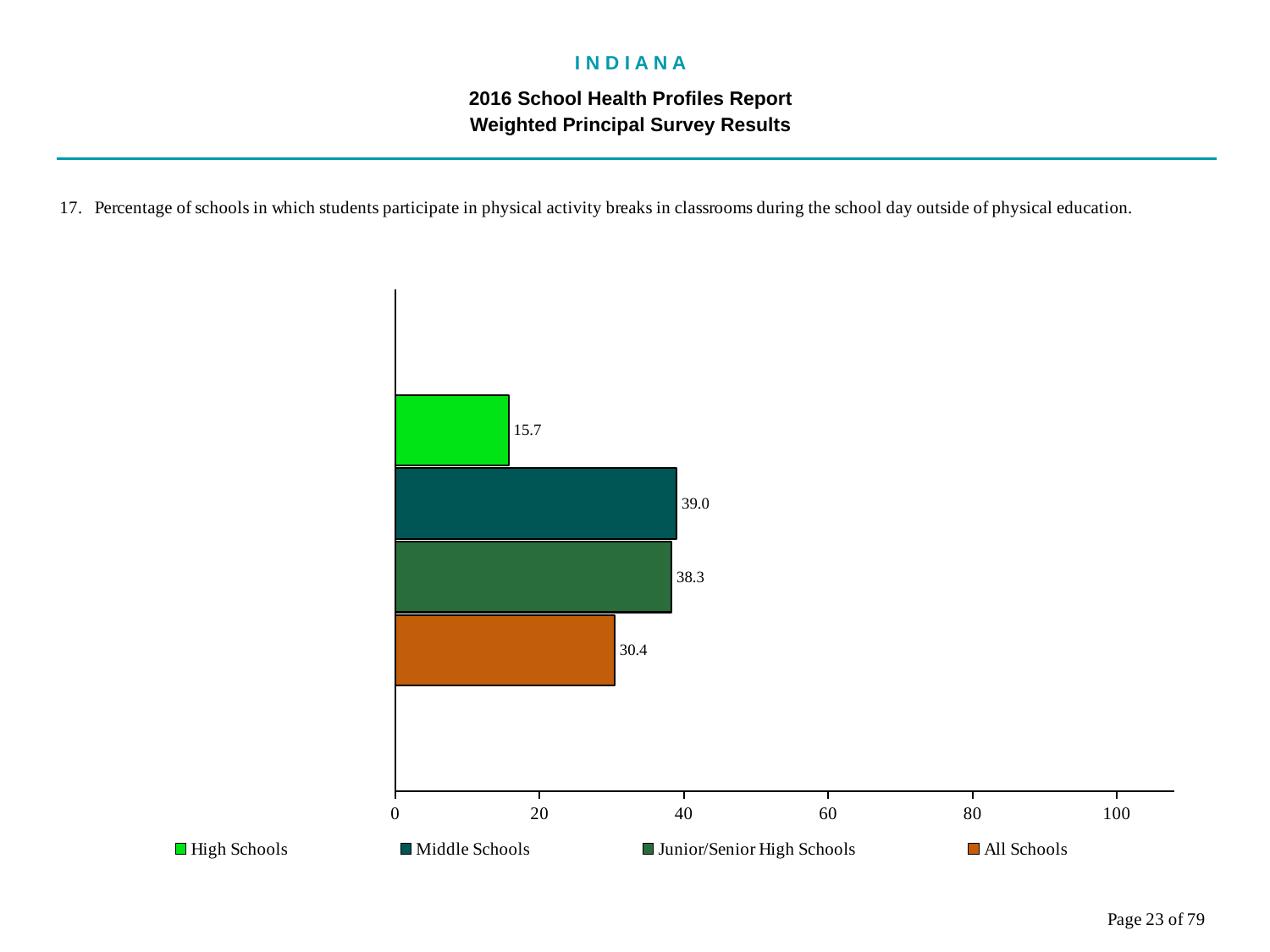
Which is larger, the value for All Schools or the value for High Schools? All Schools How many series does the legend list? 4 Which school type has the lowest value? High Schools What is the value for Junior/Senior High Schools? 38.3 What kind of chart is shown on the slide? bar chart What is the value for High Schools? 15.7 What is the value for Middle Schools? 39.0 What is the difference between the values for Middle Schools and High Schools? 23.3 What colour is the bar for All Schools? orange What is the difference between the values for Junior/Senior High Schools and All Schools? 7.9 What is the value for All Schools? 30.4 Is the value for Middle Schools greater or less than 20? greater